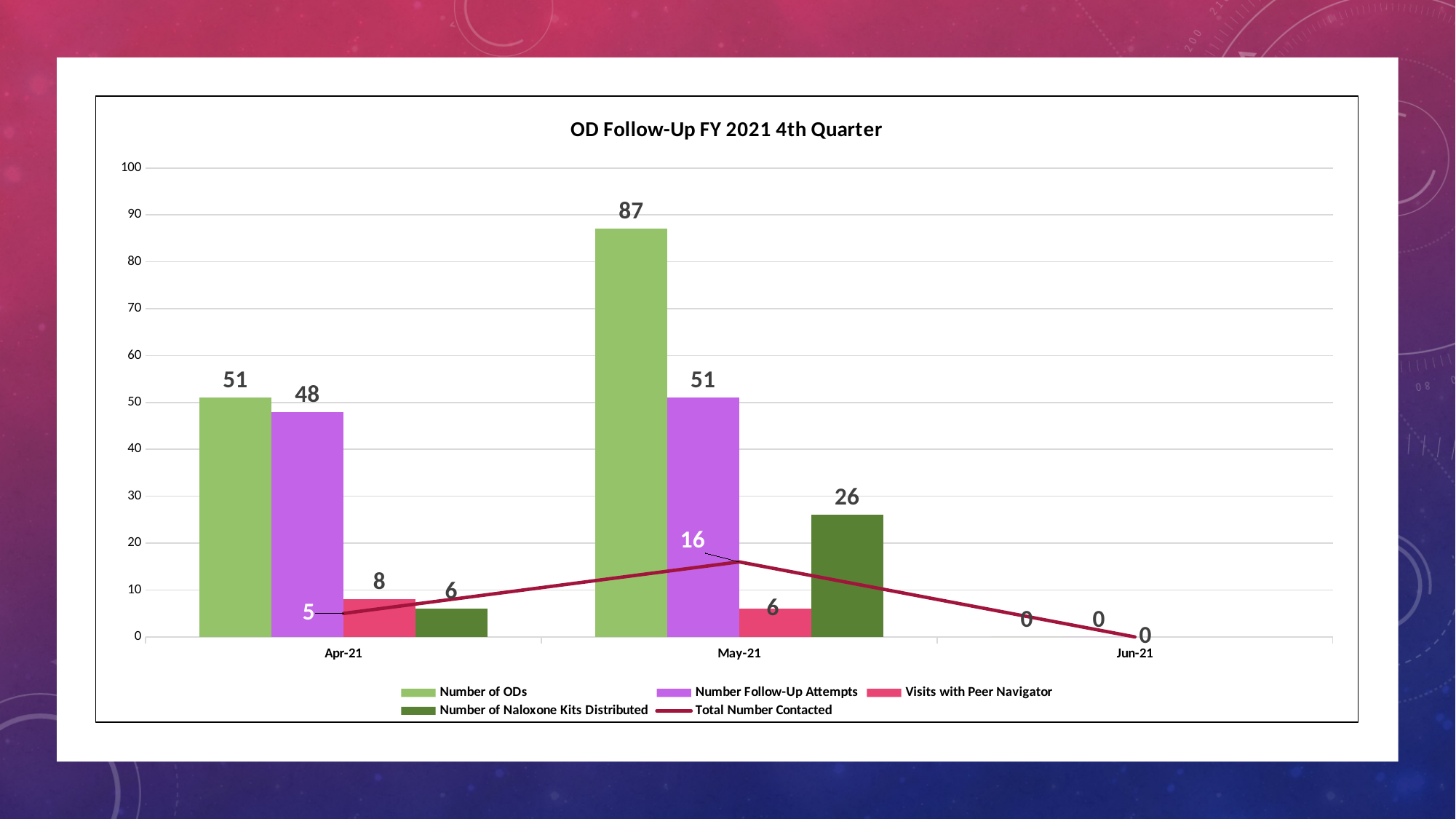
What is the difference between the Number of ODs in May-21 and Apr-21? 36 What is the Total Number Contacted for May-21? 16 Which month has the highest Number of ODs? May-21 What is the Visits with Peer Navigator value for Apr-21? 8 How many months are shown on the x axis? 3 How many series does the legend list? 5 Which is larger in May-21: Number Follow-Up Attempts or Number of Naloxone Kits Distributed? Number Follow-Up Attempts What is the Number of ODs for May-21? 87 What is the title of the chart? OD Follow-Up FY 2021 4th Quarter Which series is drawn as a line rather than bars? Total Number Contacted How many Naloxone Kits were distributed in May-21? 26 What is the Number Follow-Up Attempts value for Apr-21? 48